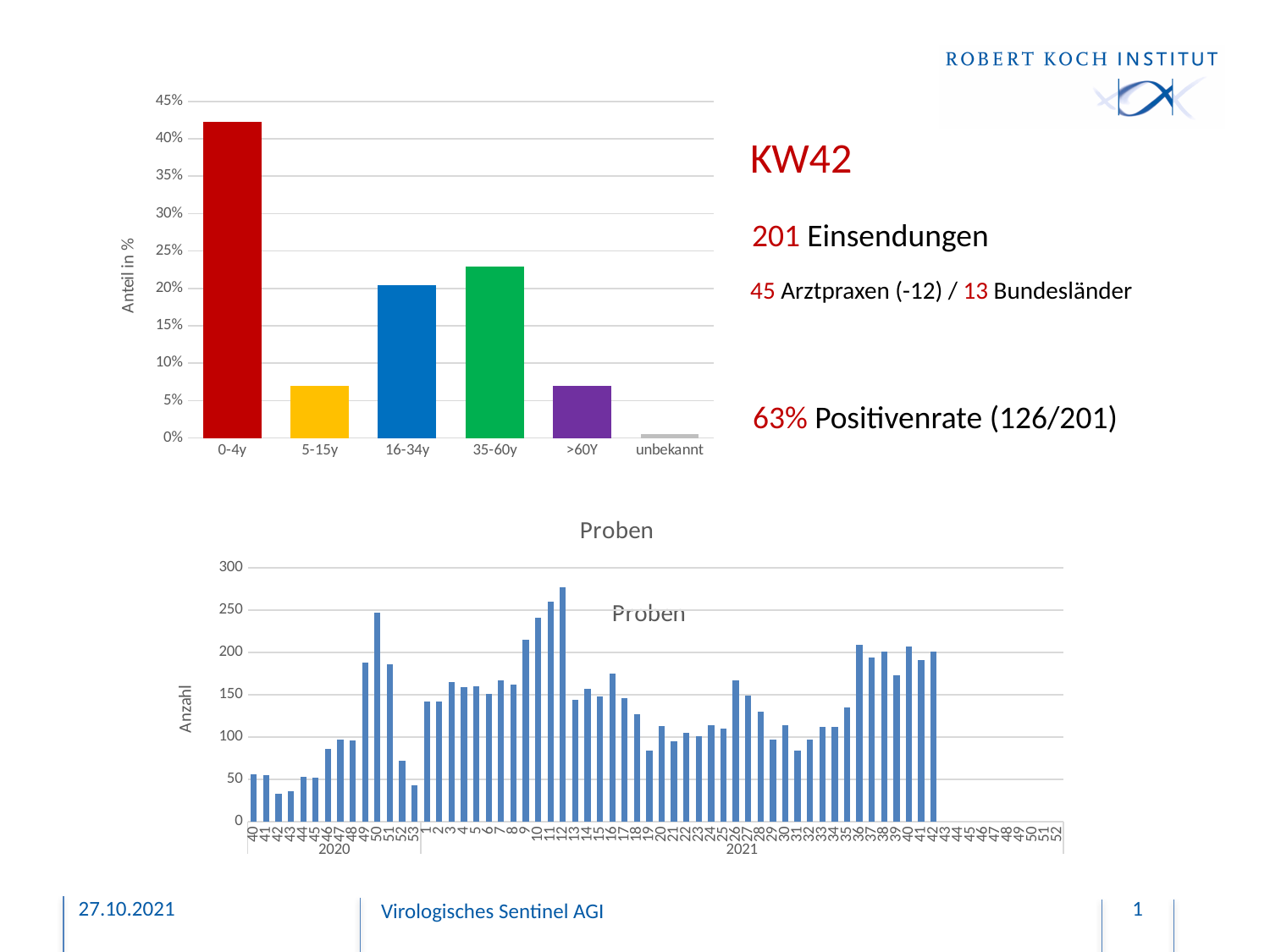
In the top-left chart, which is larger, the value for 16-34y or for 35-60y? 35-60y In the top-left chart, is the value for 16-34y greater or less than 25%? less In the top-left chart, is the value for 0-4y greater or less than 40%? greater In the top-left chart, which age group has the highest share? 0-4y What kind of chart is the top-left chart? bar chart In the 'Proben' chart, in which week of 2021 is the number of samples highest? 12 How many categories are shown on the x axis of the top-left chart? 6 In the top-left chart, is the value for 5-15y greater or less than 10%? less In the top-left chart, which category has the lowest share? unbekannt What is the y-axis label of the top-left chart? Anteil in %